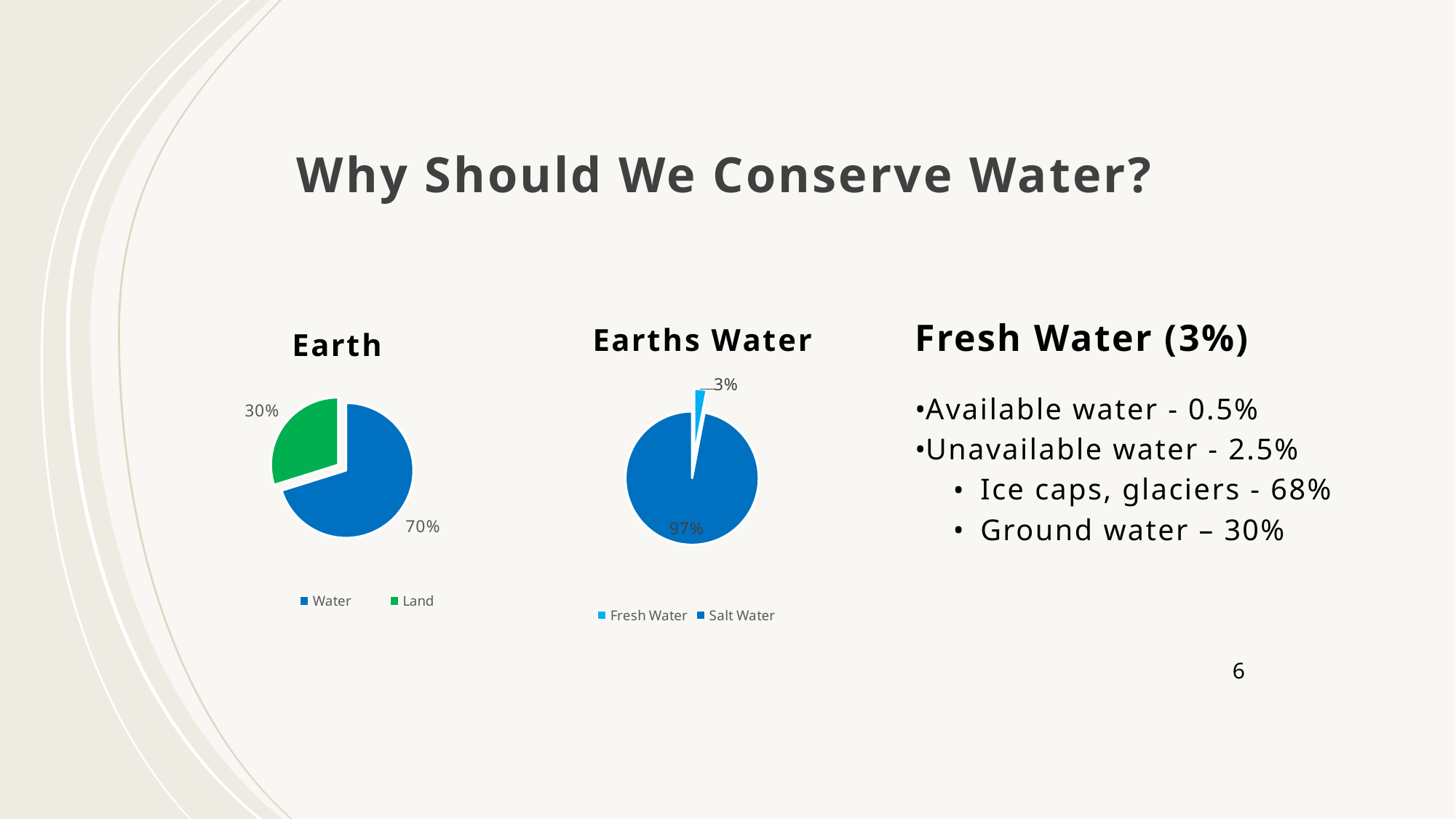
In the 'Earth' chart, what percentage is shown for Water? 70% In the 'Earth' chart, what colour is the Land slice? Green In the 'Earth' chart, which is larger, Water or Land? Water In the 'Earth' chart, which category has the largest slice? Water In the 'Earths Water' chart, what percentage is shown for Salt Water? 97% In the 'Earth' chart, what percentage is shown for Land? 30% In the 'Earths Water' chart, what percentage is shown for Fresh Water? 3% In the 'Earth' chart, what is the difference between the Water and Land percentages? 40% How many categories does the legend of the 'Earth' chart list? 2 What type of chart is the 'Earths Water' chart? Pie chart In the 'Earths Water' chart, what is the difference between the Salt Water and Fresh Water percentages? 94% In the 'Earths Water' chart, which category has the smallest slice? Fresh Water